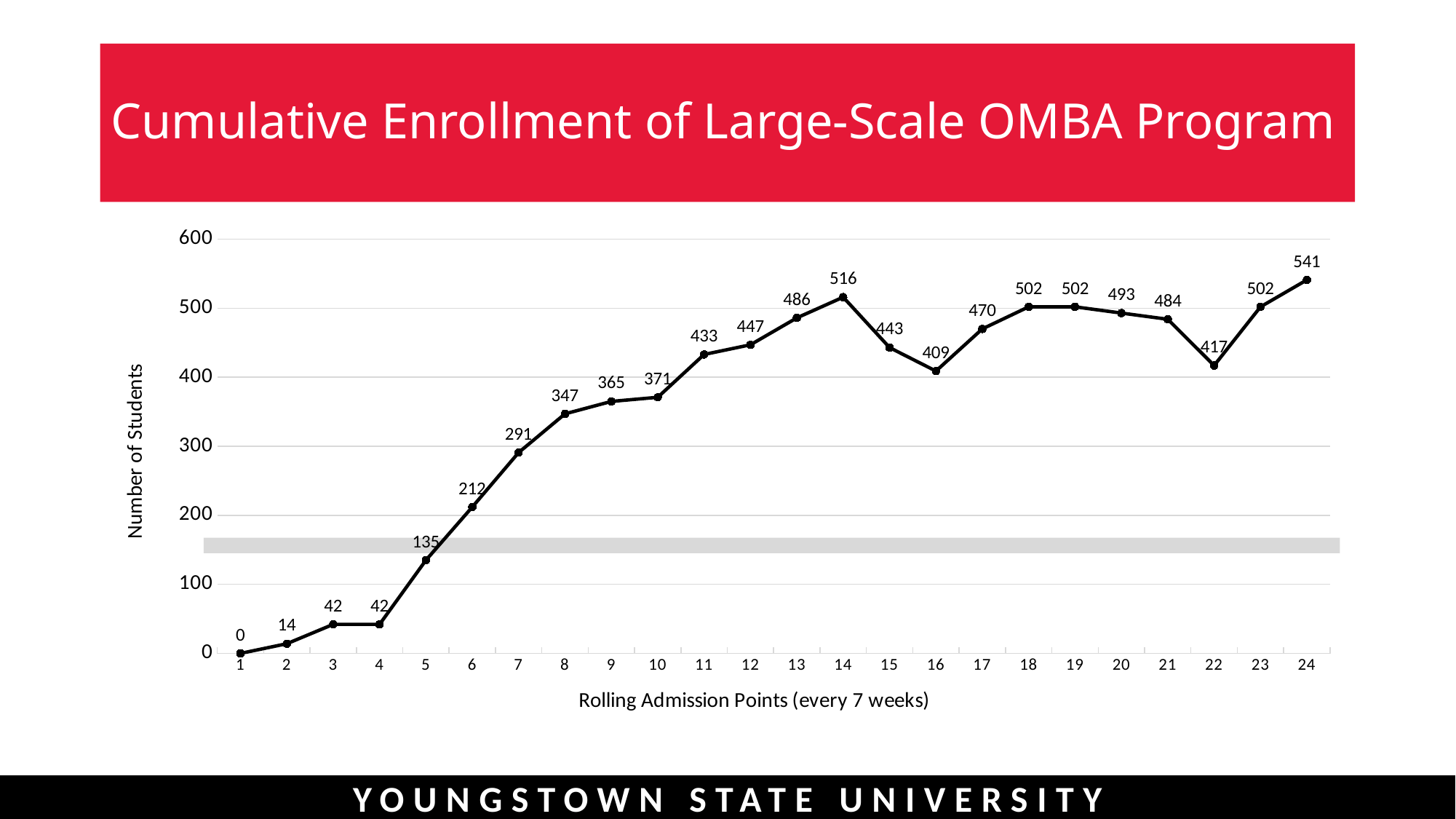
Which has more students, admission point 16 or admission point 17? Admission point 17 What is the number of students at rolling admission point 6? 212 What is the difference in number of students between admission point 14 and admission point 15? 73 At which rolling admission point is the number of students lowest? 1 What is the label of the x axis? Rolling Admission Points (every 7 weeks) How many rolling admission points are plotted on the chart? 24 At which rolling admission point is the number of students highest? 24 What kind of chart is shown on the slide? Line chart What is the difference in number of students between admission point 24 and admission point 23? 39 What is the number of students at rolling admission point 14? 516 What is the number of students at rolling admission point 22? 417 Do the values generally rise or fall from admission point 1 to admission point 14? Rise